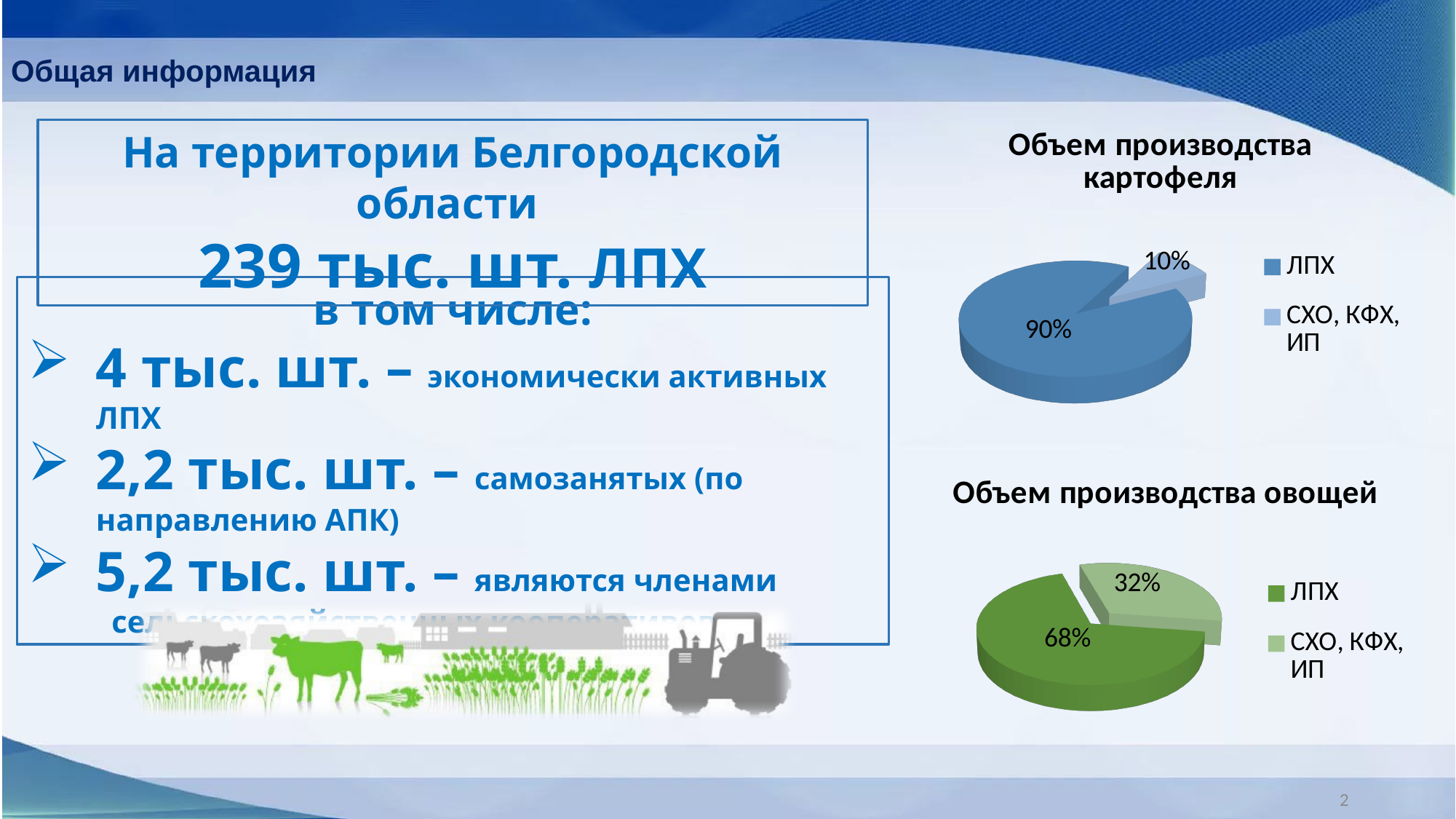
What type of chart is the chart titled 'Объем производства овощей'? Pie chart In the chart titled 'Объем производства овощей', which category has the smallest slice? СХО, КФХ, ИП In the chart titled 'Объем производства картофеля', what share does ЛПХ hold? 90% In the chart titled 'Объем производства картофеля', which category has the largest slice? ЛПХ In the chart titled 'Объем производства овощей', what share does 'СХО, КФХ, ИП' hold? 32% In the chart titled 'Объем производства овощей', what share does ЛПХ hold? 68% Is the ЛПХ share larger in the chart titled 'Объем производства картофеля' or in the chart titled 'Объем производства овощей'? Объем производства картофеля In the chart titled 'Объем производства картофеля', what share does 'СХО, КФХ, ИП' hold? 10% In the chart titled 'Объем производства овощей', what is the difference in percentage points between the ЛПХ slice and the 'СХО, КФХ, ИП' slice? 36 percentage points In the chart titled 'Объем производства картофеля', what is the difference in percentage points between the ЛПХ slice and the 'СХО, КФХ, ИП' slice? 80 percentage points How many categories does the legend of the chart titled 'Объем производства картофеля' list? 2 What colour is the ЛПХ slice in the chart titled 'Объем производства овощей'? Green